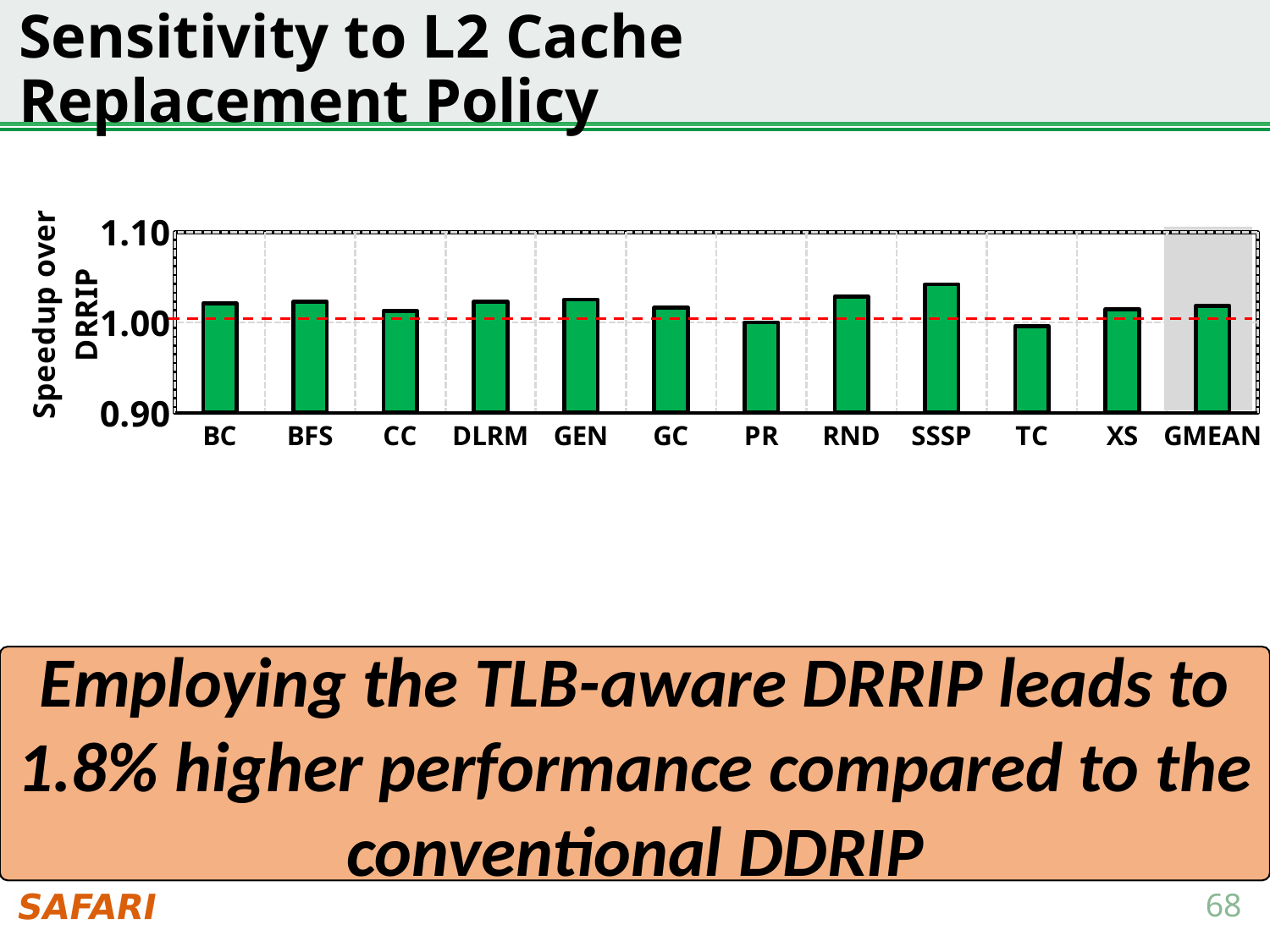
Is the value for BC greater or less than 1.00? greater Which category has the lowest speedup over DRRIP? TC Is the value for SSSP greater or less than 1.10? less How many categories are shown on the x axis of the chart? 12 What kind of chart is shown on the slide? bar chart Which is larger, the value for SSSP or the value for TC? SSSP Which category on the chart is highlighted with a grey shaded background? GMEAN Is the value for TC greater or less than 1.00? less Which category has the highest speedup over DRRIP? SSSP What is the label of the y axis of the chart? Speedup over DRRIP Which is larger, the value for RND or the value for PR? RND